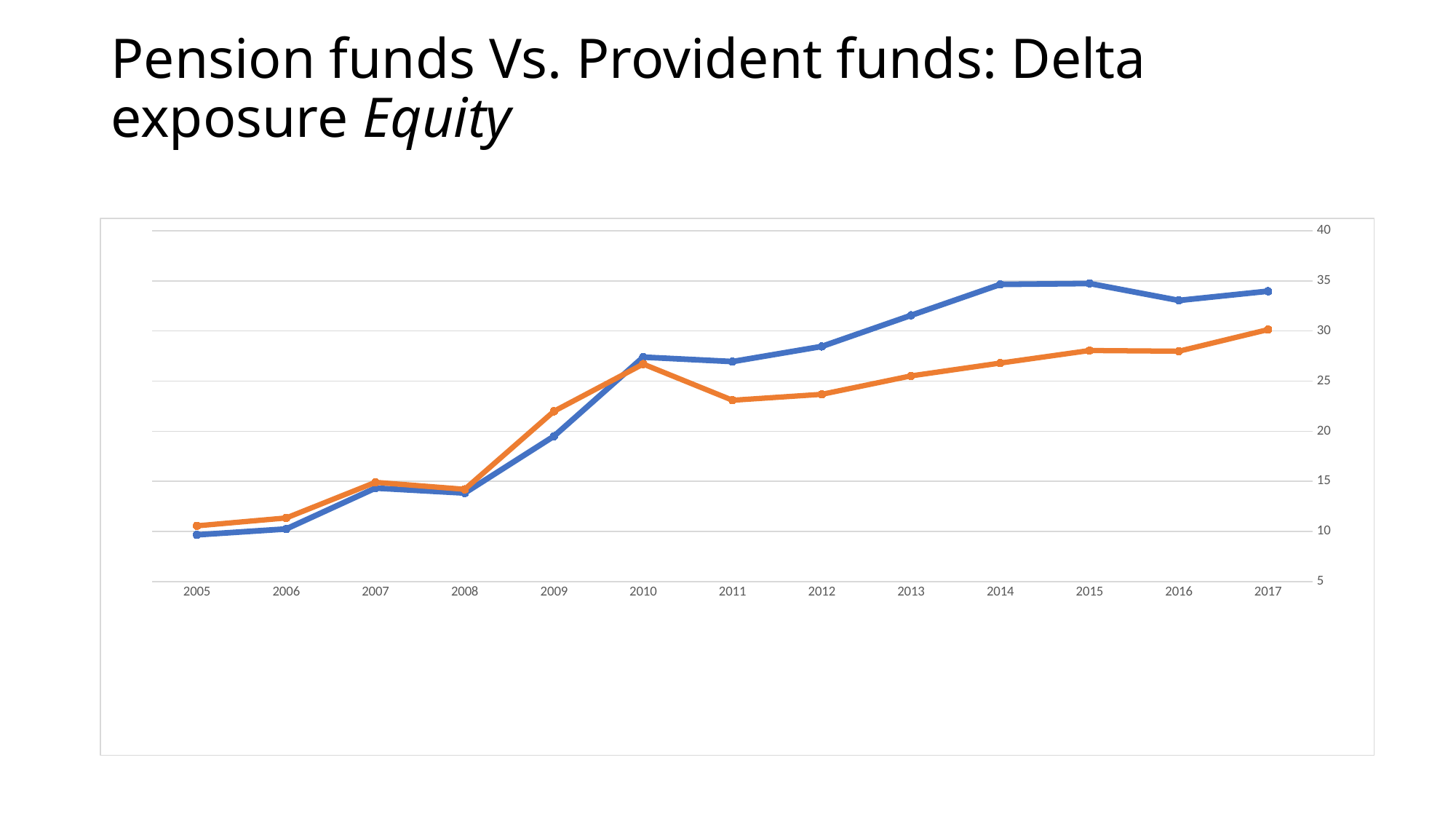
What kind of chart is shown on the slide? line chart Is the value of the blue line in 2014 greater or less than 30? greater In which year does the orange line reach its highest value? 2017 In 2014, which line has the higher value, the blue line or the orange line? the blue line Is the value of the orange line in 2015 greater or less than 30? less How many lines are plotted on the chart? 2 Is the value of the orange line in 2011 greater or less than 25? less What is the first year shown on the x axis? 2005 What is the title of the slide containing the chart? Pension funds Vs. Provident funds: Delta exposure Equity How many years are shown along the x axis of the chart? 13 In 2009, which line has the higher value, the blue line or the orange line? the orange line